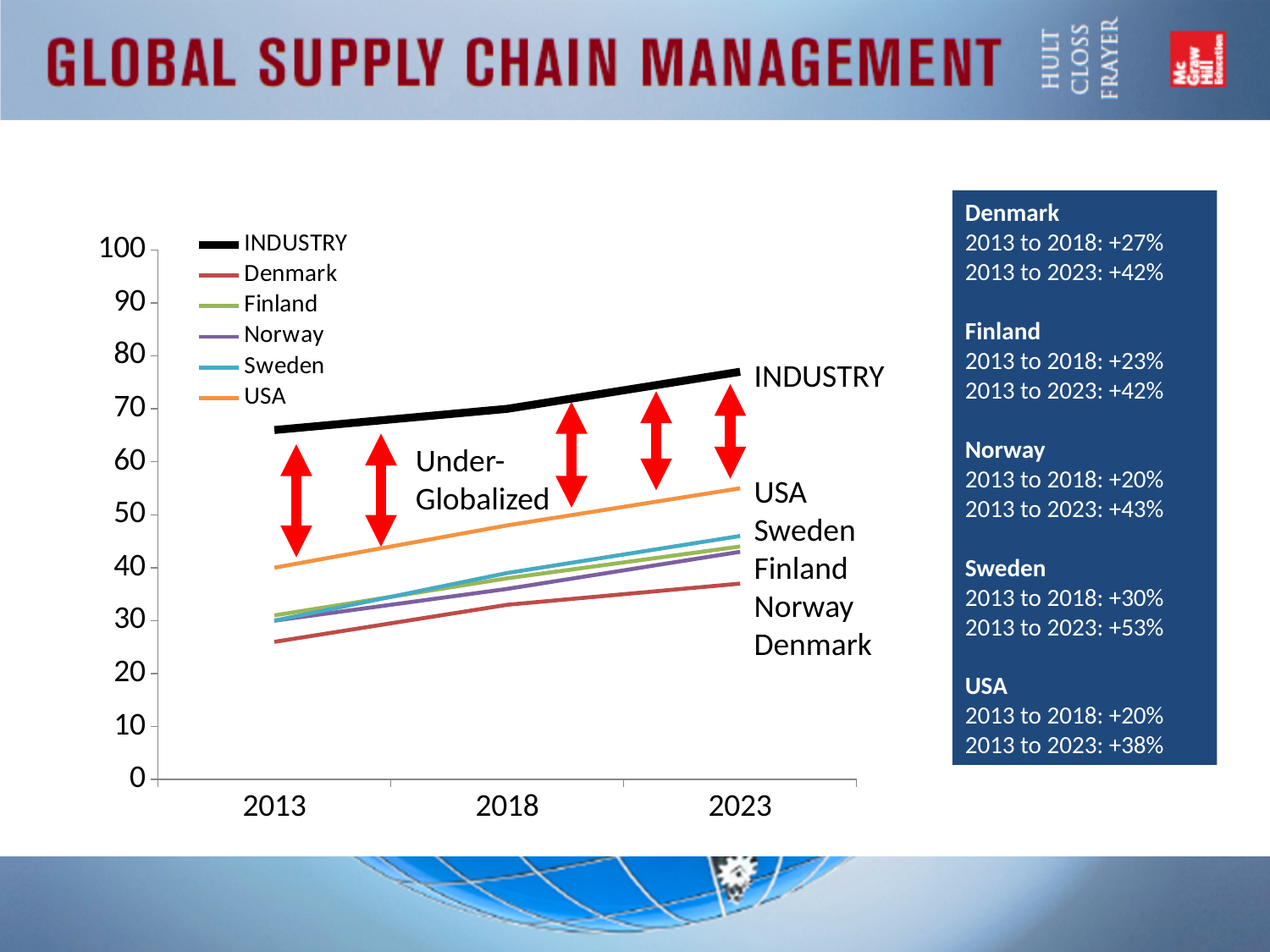
What kind of chart is shown on the slide? line chart Which series has the lowest values across all years in the chart? Denmark How many series does the chart legend list? 6 Is the value for INDUSTRY in 2023 greater or less than 70? greater Which series has the highest values across all years in the chart? INDUSTRY Is the value for INDUSTRY in 2013 greater or less than 60? greater What annotation text is written between the INDUSTRY line and the USA line on the chart? Under-Globalized How many years are shown on the x axis of the chart? 3 Is the value for Denmark in 2013 greater or less than 30? less Do the values for the INDUSTRY series rise or fall from 2013 to 2023? rise In 2023, which is larger: the value for USA or the value for Denmark? USA